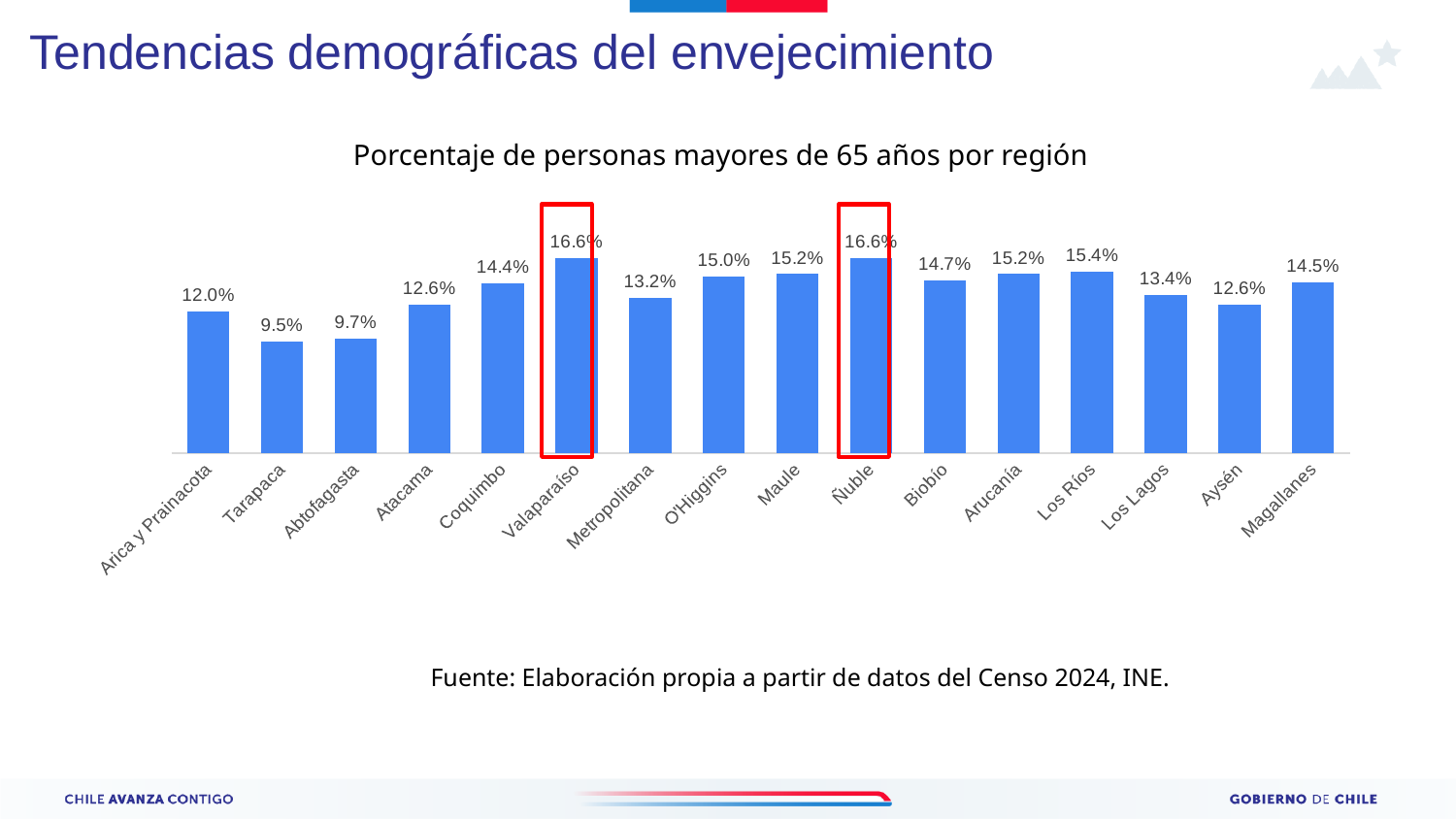
What is the difference between the values for Maule and Atacama? 2.6% Which region has the lowest percentage of people over 65? Tarapaca Which two regions are highlighted with red boxes in the chart? Valaparaíso and Ñuble What is the value for Magallanes? 14.5% What is the value for Metropolitana? 13.2% What is the value for Los Ríos? 15.4% Which has a larger value, Coquimbo or Biobío? Biobío What type of chart is shown on the slide? bar chart Which two regions share the highest value in the chart? Valaparaíso and Ñuble What is the title of the chart? Porcentaje de personas mayores de 65 años por región How many regions are shown in the chart? 16 What is the difference between the values for Ñuble and Tarapaca? 7.1%